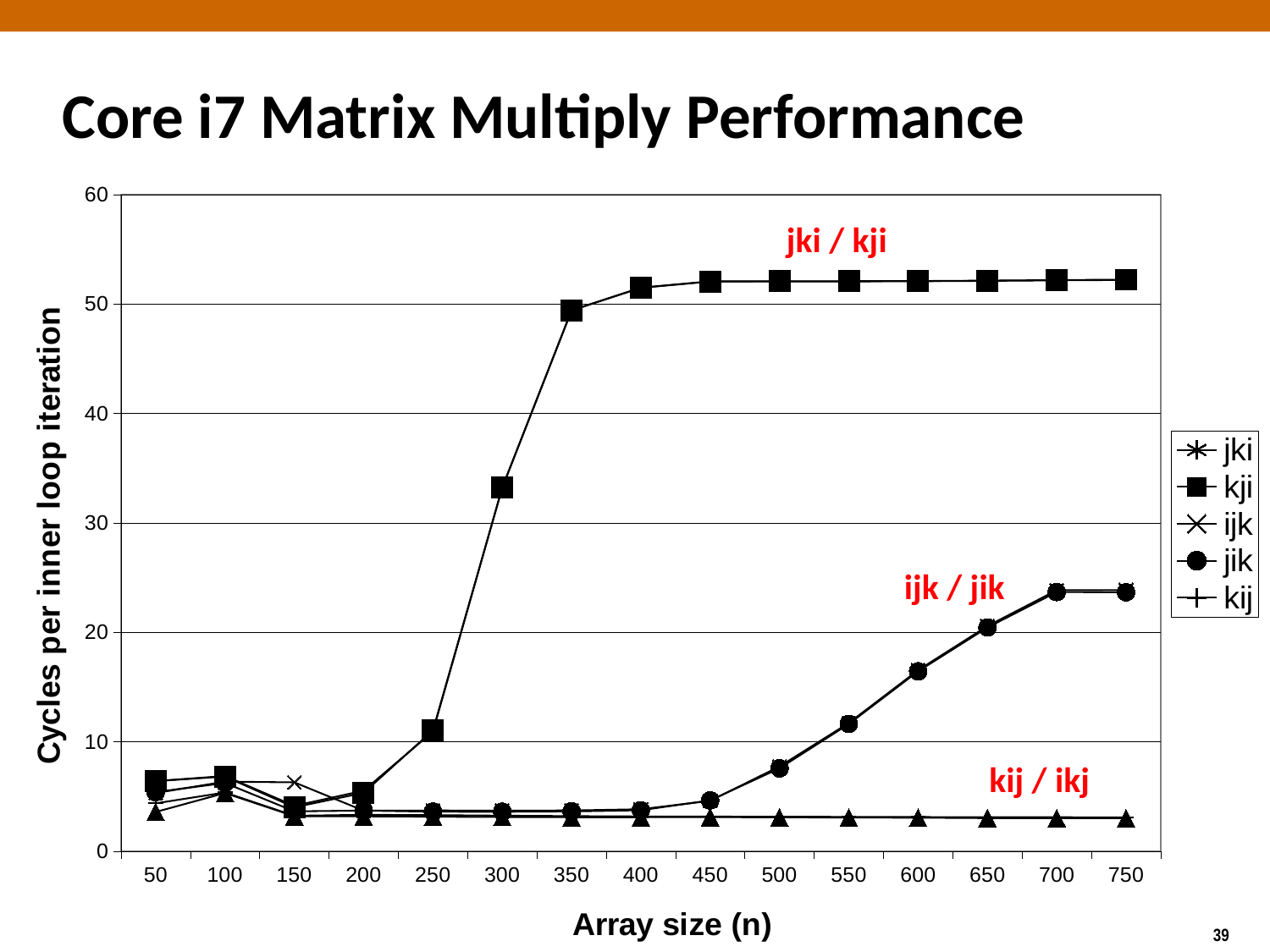
How many array sizes are plotted along the x axis? 15 What is the label of the y axis? Cycles per inner loop iteration Does the kji series rise or fall as array size increases from 200 to 400? rise Is the value for kji at array size 750 greater or less than 50? greater Is the value for jik at array size 400 greater or less than 10? less How many series does the chart's legend list? 5 What kind of chart is shown on the slide? line chart Is the value for kji at array size 300 greater or less than 30? greater What is the title of the chart? Core i7 Matrix Multiply Performance